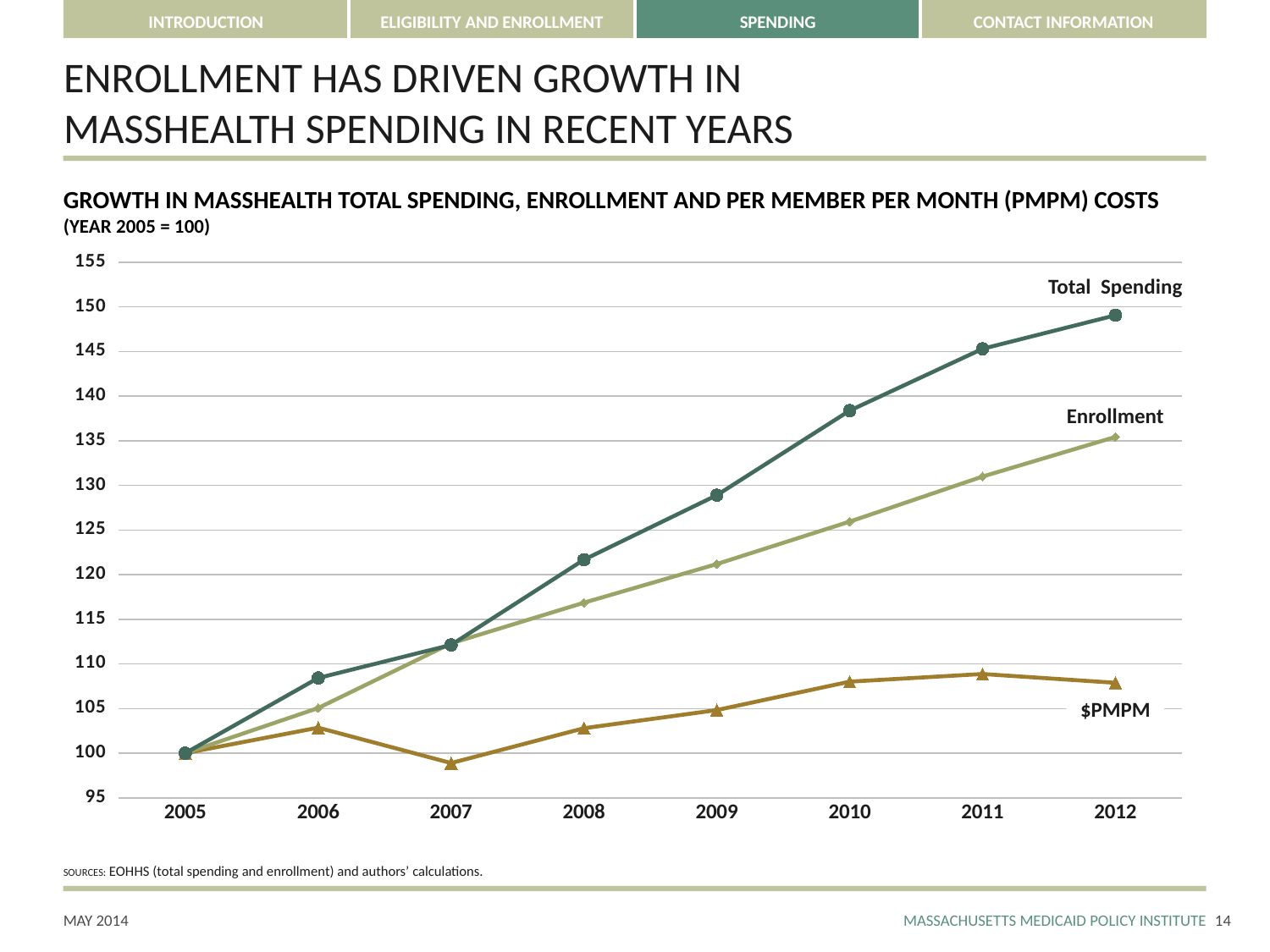
Is the value for Total Spending in 2012 greater or less than 145? greater Which series has the highest value in 2012? Total Spending Does the Total Spending series rise or fall from 2005 to 2012? rise How many years are shown along the x axis of the chart? 8 Which series has the lowest value in 2012? $PMPM What kind of chart is shown on the slide? line chart Is the value for Enrollment in 2012 greater or less than 140? less What is the index value of Total Spending in 2005? 100 Is the value for $PMPM in 2011 greater or less than 105? greater In 2010, which is larger: Total Spending or Enrollment? Total Spending What base year is the index set to 100, according to the chart subtitle? 2005 How many series are plotted on the chart? 3